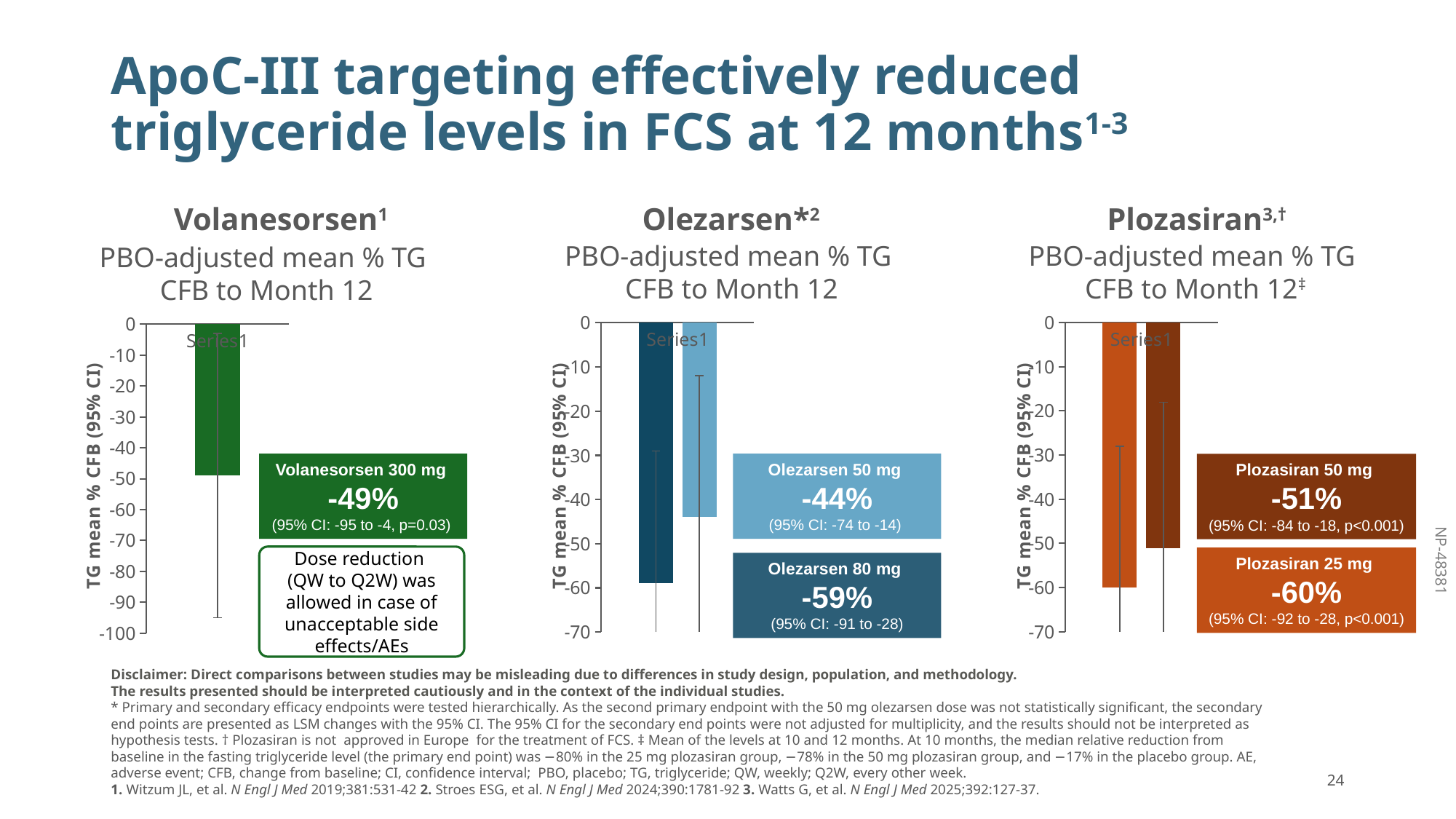
In the Plozasiran chart, which dose shows the larger reduction in TG, 25 mg or 50 mg? 25 mg In the Volanesorsen chart, what is the 95% CI shown for Volanesorsen 300 mg? -95 to -4 In the Olezarsen chart, what is the PBO-adjusted mean % TG change from baseline for Olezarsen 50 mg? -44% In the Plozasiran chart, what is the PBO-adjusted mean % TG change from baseline for Plozasiran 25 mg? -60% In the Volanesorsen chart, what is the PBO-adjusted mean % TG change from baseline for Volanesorsen 300 mg? -49% In the Plozasiran chart, by how many percentage points does the reduction for Plozasiran 25 mg exceed that for Plozasiran 50 mg? 9 percentage points In the Plozasiran chart, what is the PBO-adjusted mean % TG change from baseline for Plozasiran 50 mg? -51% How many bars are plotted in the Olezarsen chart? 2 In the Olezarsen chart, what is the PBO-adjusted mean % TG change from baseline for Olezarsen 80 mg? -59% In the Olezarsen chart, which dose shows the larger reduction in TG, 50 mg or 80 mg? 80 mg In the Olezarsen chart, by how many percentage points does the reduction for Olezarsen 80 mg exceed that for Olezarsen 50 mg? 15 percentage points What kind of chart is used for the Plozasiran data? Bar chart